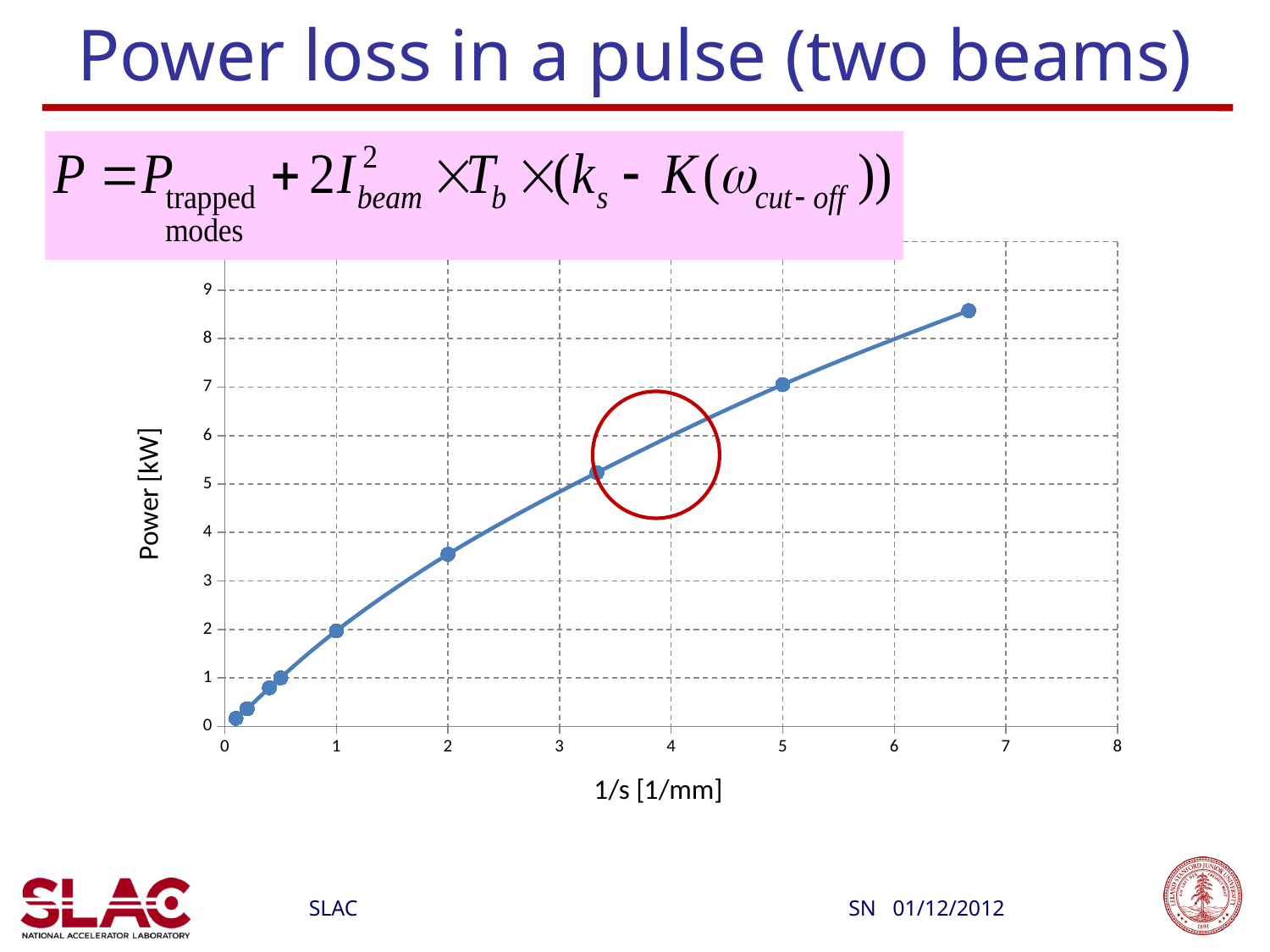
What is the highest tick value shown on the x axis? 8 What is the highest tick value shown on the y axis? 9 What kind of chart is shown on the slide? line chart What is the label of the x axis of the chart? 1/s [1/mm] Does the power rise or fall as 1/s increases along the x axis? rises Is the power value at 1/s = 2 greater or less than 4 kW? less Is the power value of the rightmost data point greater or less than 8 kW? greater Which data point has the highest power: the one at 1/s = 5 or the one at 1/s = 2? the one at 1/s = 5 Is the power value at 1/s = 2 greater or less than 3 kW? greater